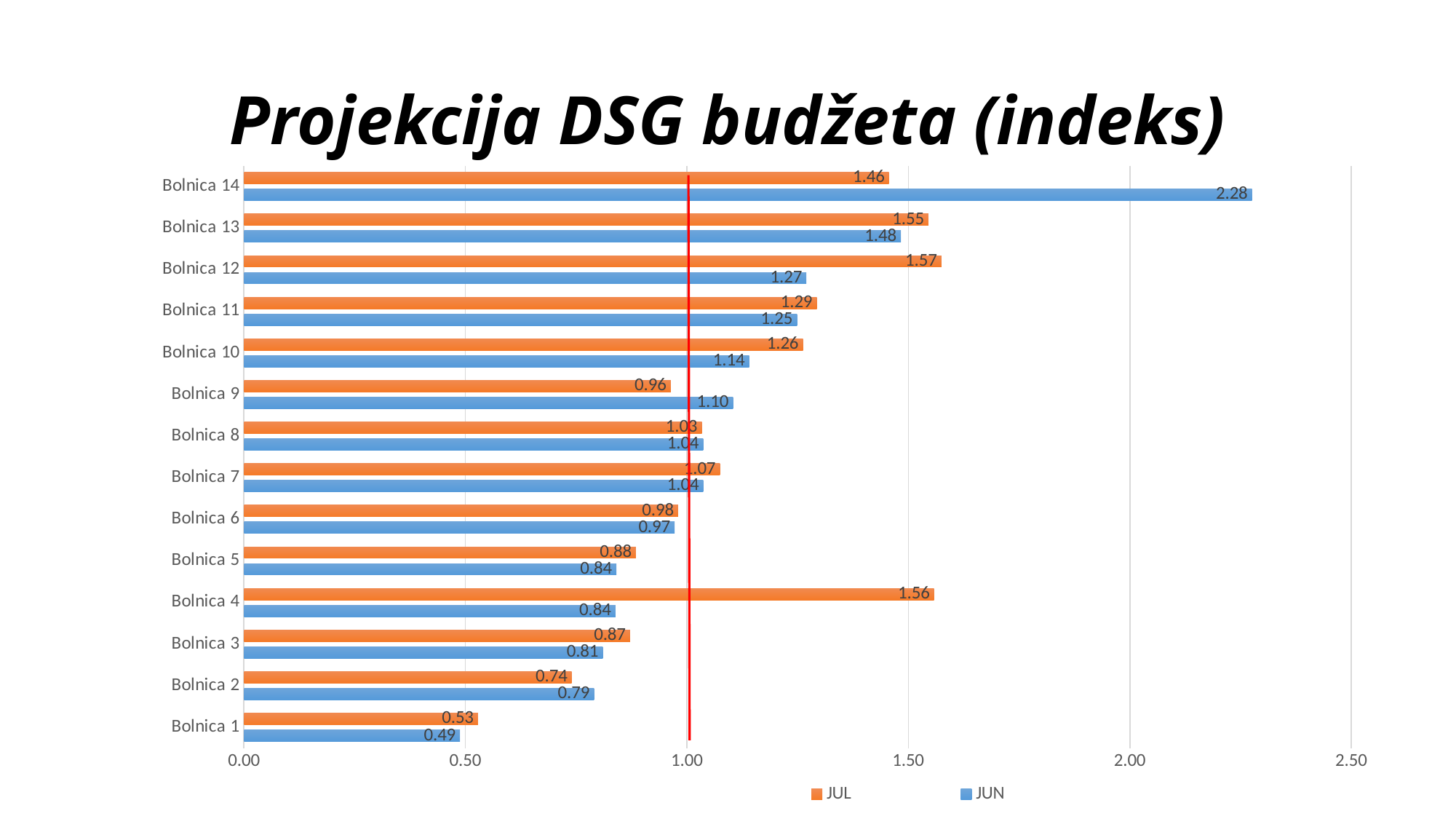
What is the difference between the JUN and JUL values for Bolnica 14? 0.82 Which hospital has the lowest JUN value? Bolnica 1 How many hospitals (categories) are shown on the chart? 14 What is the JUN value for Bolnica 9? 1.10 Which hospital has the highest JUN value? Bolnica 14 What type of chart is shown on the slide? Bar chart What is the JUL value for Bolnica 4? 1.56 What is the JUL value for Bolnica 1? 0.53 How many series does the legend list? 2 What is the difference between the JUL and JUN values for Bolnica 4? 0.72 What is the JUN value for Bolnica 14? 2.28 For Bolnica 9, which is larger, the JUL value or the JUN value? JUN